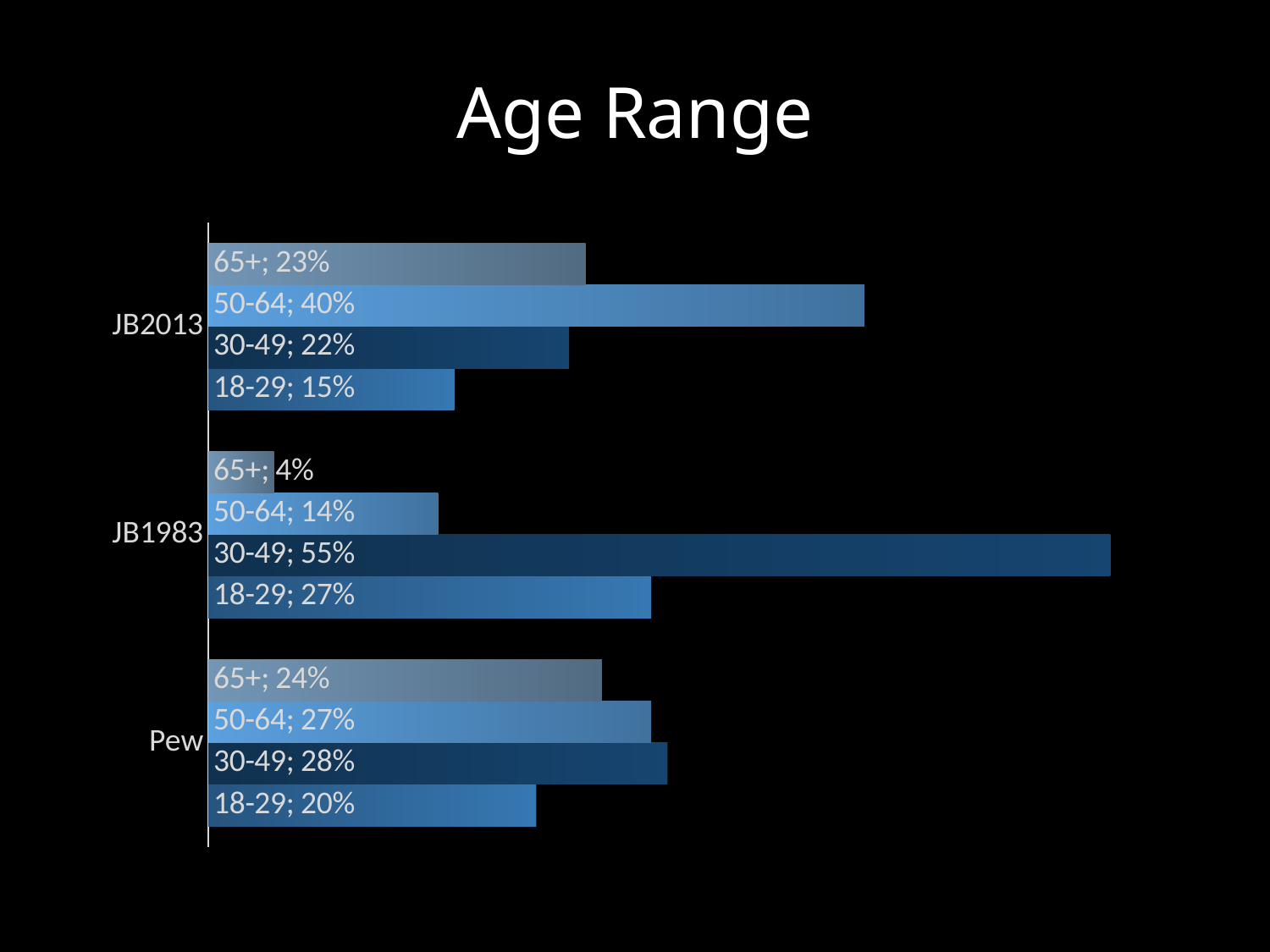
What is the value for the 30-49 age group in the JB1983 category? 55% What type of chart is shown on the slide? Bar chart What is the value for the 65+ age group in the Pew category? 24% Which age group has the highest value in the JB2013 category? 50-64 What is the difference between the 30-49 value in JB1983 and the 30-49 value in JB2013? 33% What is the value for the 18-29 age group in the JB1983 category? 27% What is the difference between the 65+ value in Pew and the 65+ value in JB1983? 20% How many categories are shown on the vertical axis? 3 What is the value for the 50-64 age group in the JB2013 category? 40% Which is larger: the 18-29 value in JB2013 or the 18-29 value in Pew? Pew How many age-group series are plotted for each category? 4 Which age group has the lowest value in the JB1983 category? 65+